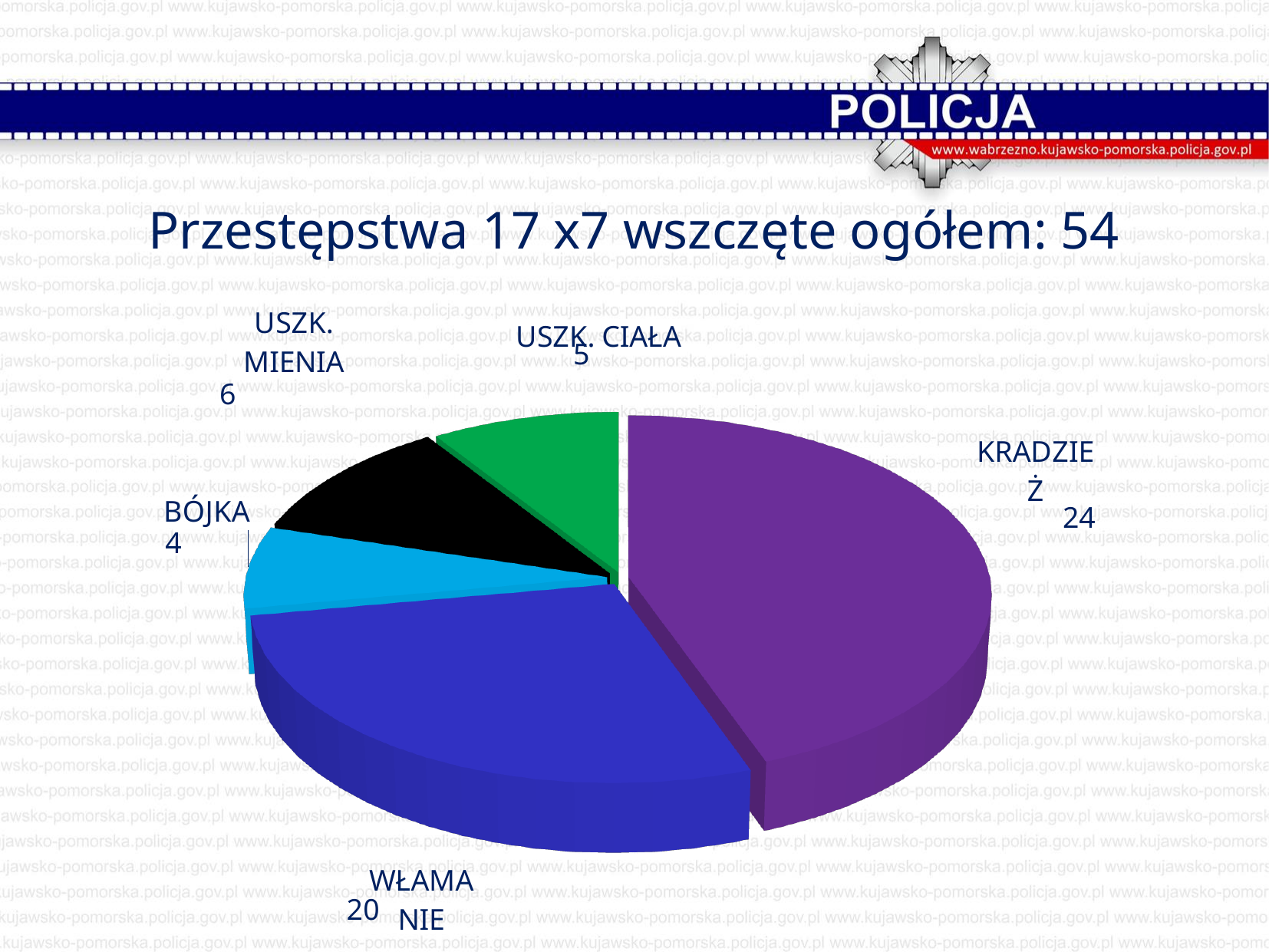
What kind of chart is shown on the slide? pie chart What is the value for BÓJKA? 4 Which is larger, the value for USZK. MIENIA or the value for USZK. CIAŁA? USZK. MIENIA What is the value for USZK. MIENIA? 6 What is the title of the chart? Przestępstwa 17 x7 wszczęte ogółem: 54 What is the value for KRADZIEŻ? 24 How many categories (slices) does the pie chart have? 5 What is the value for WŁAMANIE? 20 What is the difference between the values for KRADZIEŻ and WŁAMANIE? 4 Which category has the highest value? KRADZIEŻ What is the value for USZK. CIAŁA? 5 Which category has the lowest value? BÓJKA